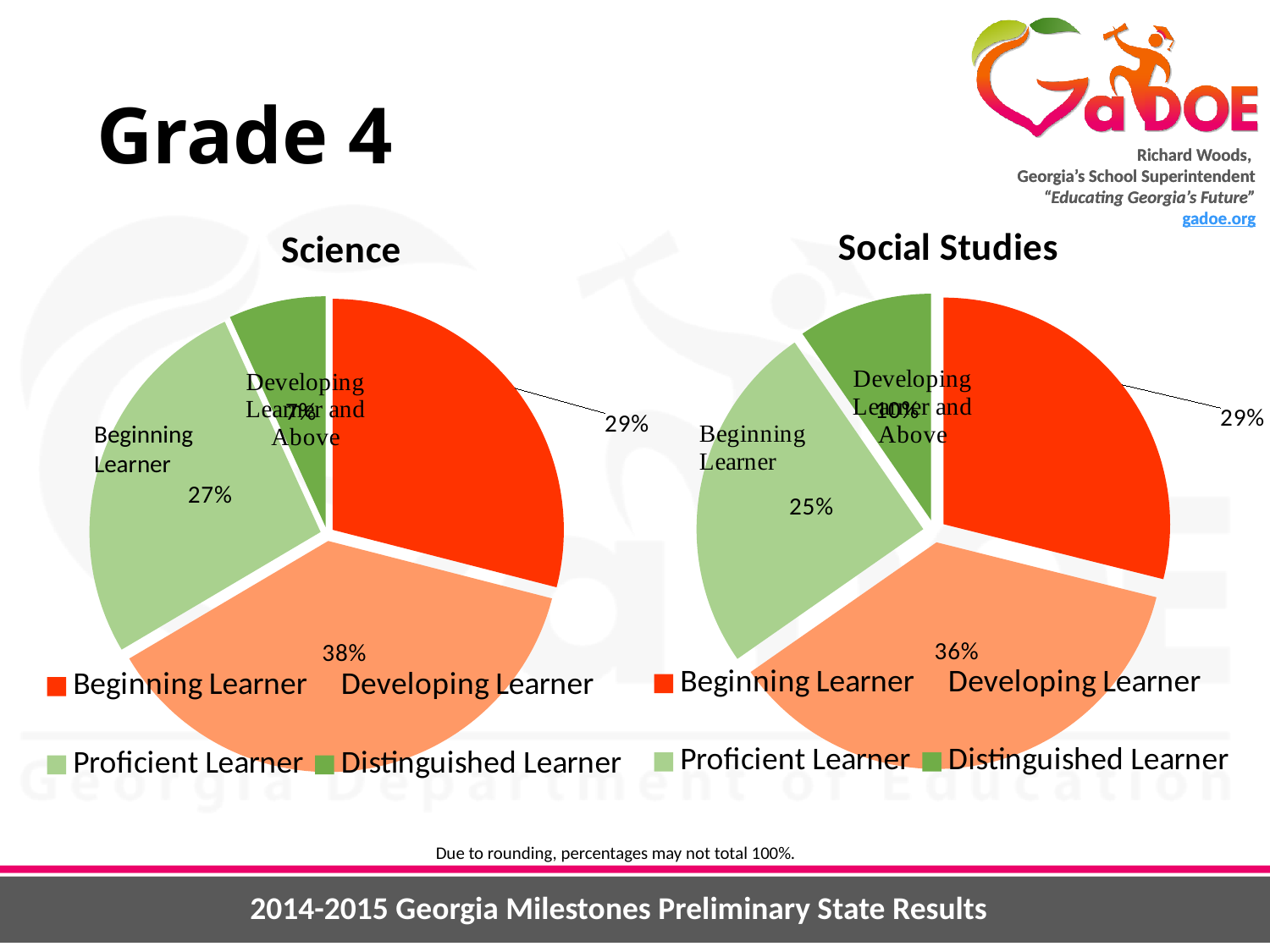
In the Science pie chart, which category has the largest share? Developing Learner In the Science pie chart, what percentage is shown for Developing Learner? 38% In the Social Studies pie chart, which category has the smallest share? Distinguished Learner How many entries does the legend of the Science chart list? 4 In the Social Studies pie chart, what percentage is shown for Proficient Learner? 25% In the Science pie chart, what is the difference between the Developing Learner and Proficient Learner percentages? 11% In the Social Studies pie chart, what percentage is shown for Developing Learner? 36% What type of chart is used for the Social Studies data? Pie chart In the Social Studies pie chart, what percentage is shown for Beginning Learner? 29% In the Science pie chart, what percentage is shown for Proficient Learner? 27% Which is larger in the Social Studies pie chart: Beginning Learner or Proficient Learner? Beginning Learner In the Science pie chart, what percentage is shown for Beginning Learner? 29%